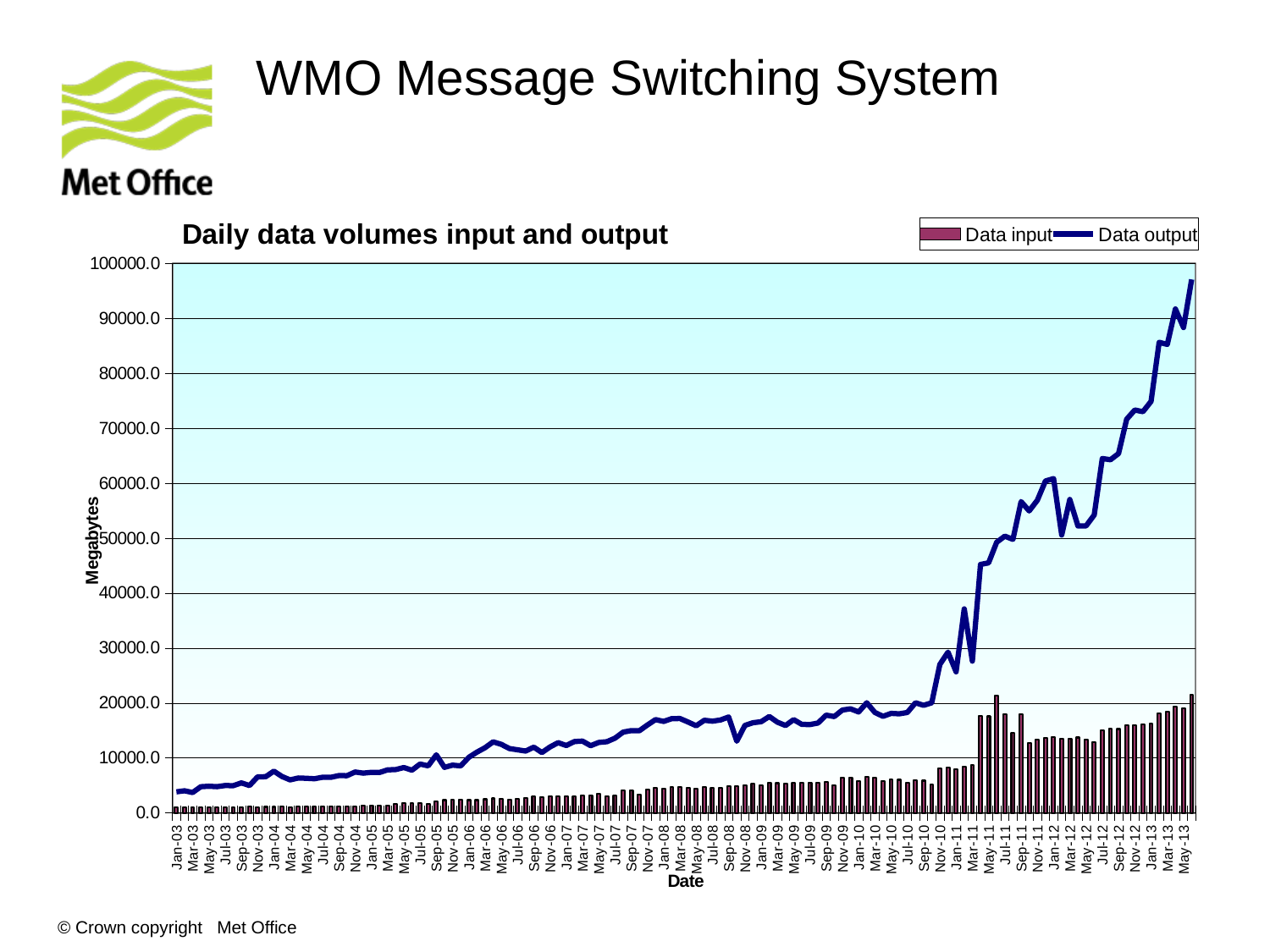
What kind of chart is used to show the Data input series? Bar chart Is the Data output value for Jan-03 greater or less than 10000.0? less What kind of chart is used to show the Data output series? Line chart What is the label on the vertical axis of the chart? Megabytes Is the Data input value for Jan-03 greater or less than 10000.0? less What is the title of the chart? Daily data volumes input and output Does the Data output series generally rise or fall from Jan-03 to May-13? Rise Which series has the larger value at May-13, Data input or Data output? Data output Is the Data input value for May-13 greater or less than 10000.0? greater How many series does the chart legend list? 2